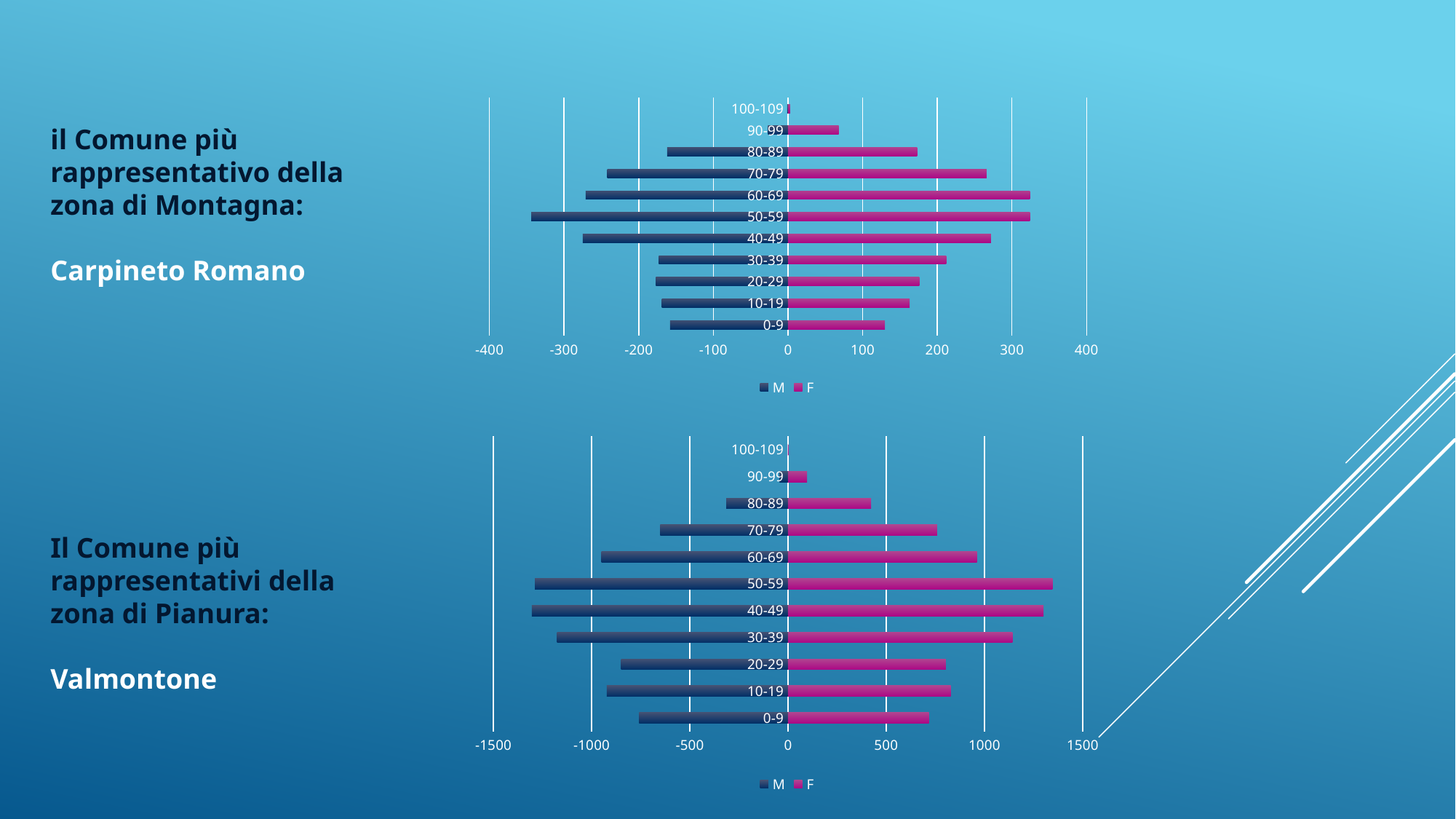
In the top chart (Carpineto Romano), which age group has the longest M bar? 50-59 In the bottom chart (Valmontone), is the F value for 20-29 greater or less than 1000? less In the bottom chart (Valmontone), is the F value for 50-59 greater or less than 1000? greater In the top chart (Carpineto Romano), is the F value for 90-99 greater or less than 100? less How many age-group categories are shown in the top chart (Carpineto Romano)? 11 What kind of chart is the top chart (Carpineto Romano)? bar chart In the bottom chart (Valmontone), which age group has the longest F bar? 50-59 How many series does the legend of the bottom chart (Valmontone) list? 2 In the bottom chart (Valmontone), which F bar is longer: 60-69 or 70-79? 60-69 In the top chart (Carpineto Romano), which F bar is longer: 40-49 or 30-39? 40-49 In the top chart (Carpineto Romano), which age group has the shortest F bar? 100-109